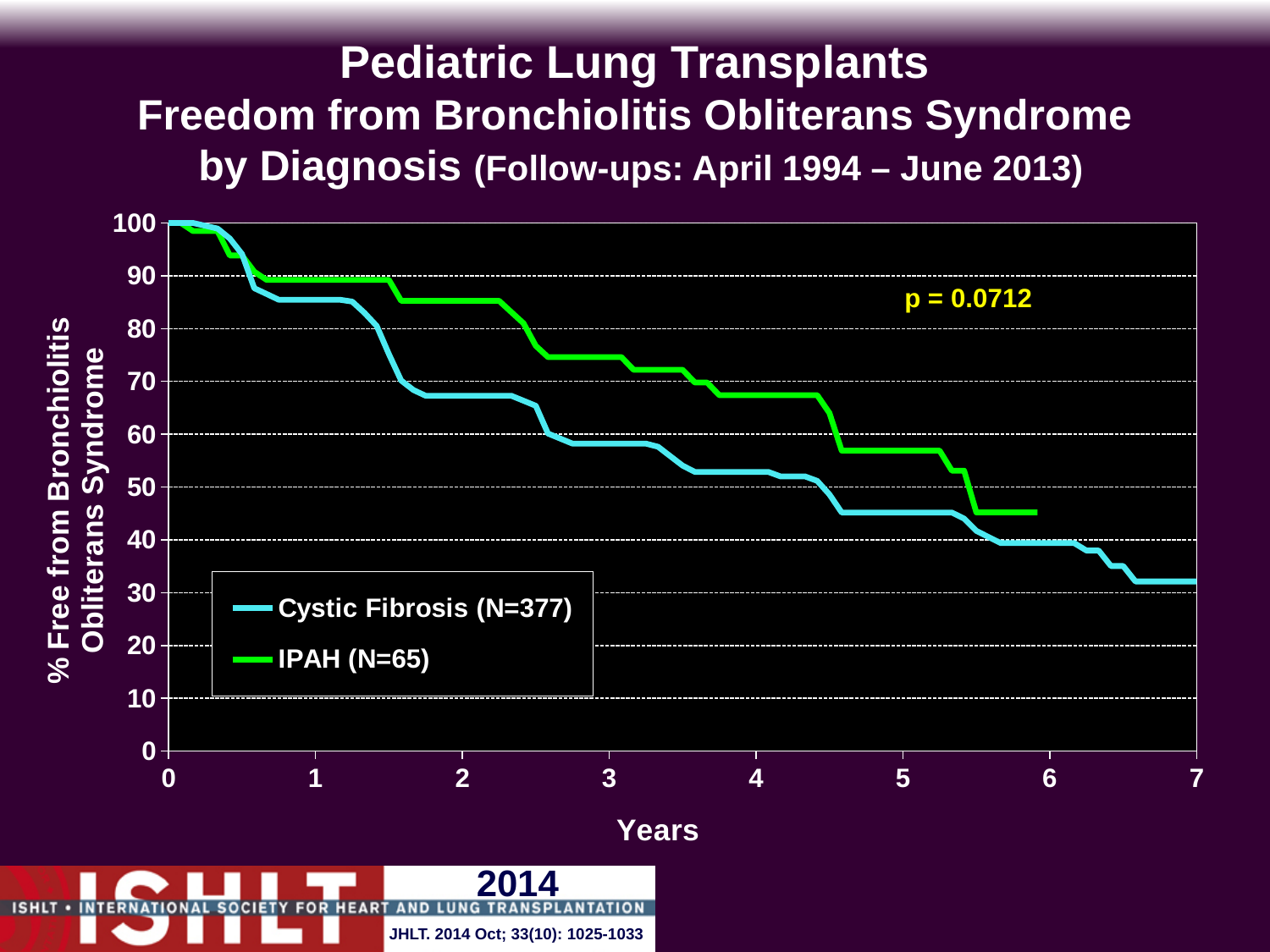
At 3 years, which series has the higher value, Cystic Fibrosis or IPAH? IPAH Is the value for Cystic Fibrosis at 2 years greater or less than 60? greater What is the N for the Cystic Fibrosis series in the legend? 377 Is the value for Cystic Fibrosis at 1 year greater or less than 80? greater Is the value for IPAH at 5 years greater or less than 50? greater How many series does the legend list? 2 Do the values for Cystic Fibrosis rise or fall as years increase? fall Do the values for IPAH rise or fall as years increase? fall What kind of chart is shown on the slide? line chart At 5 years, which series has the higher value, Cystic Fibrosis or IPAH? IPAH What is the p-value shown on the chart? p = 0.0712